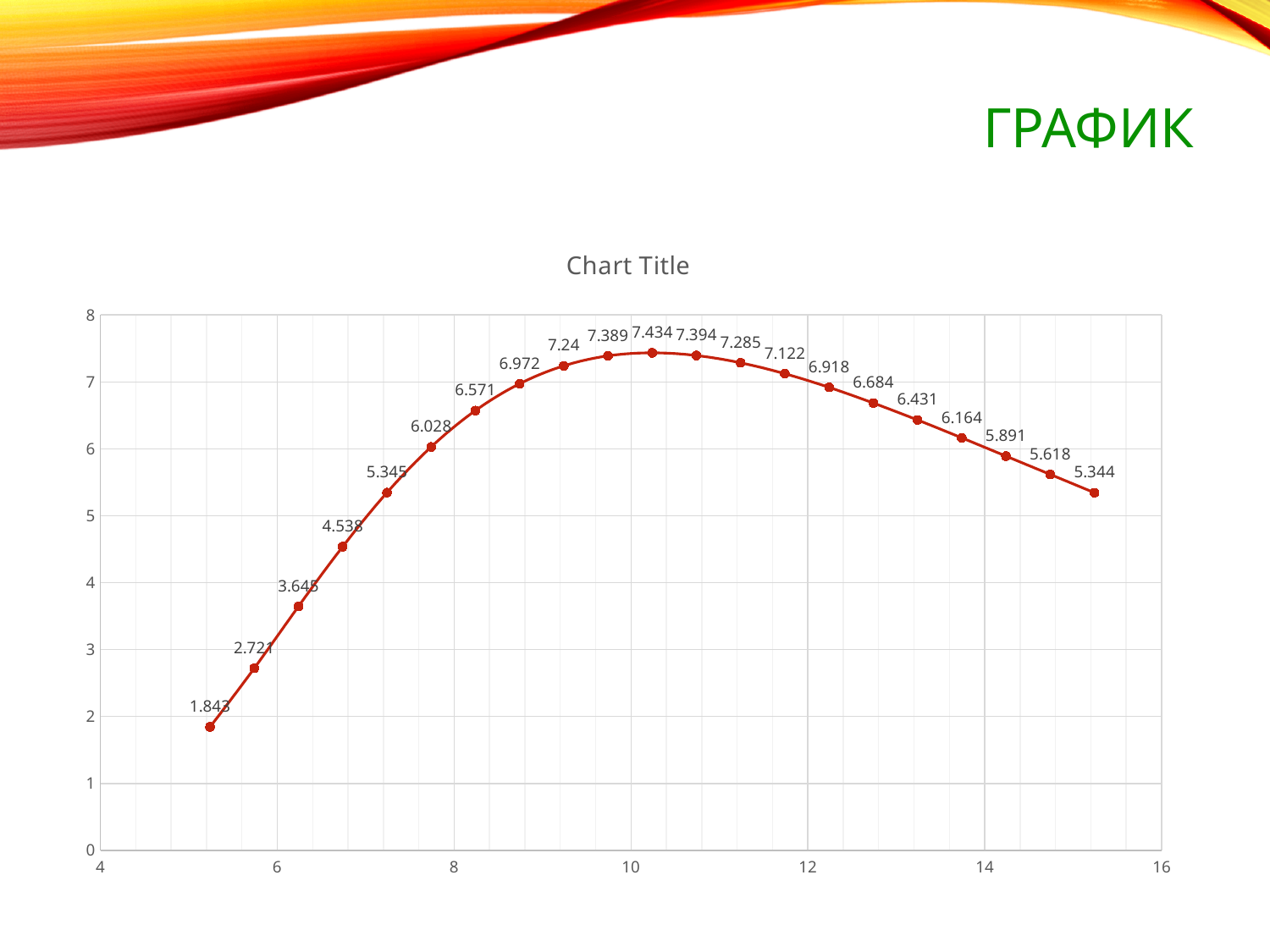
What kind of chart is shown on the slide? line chart How do the values change along the x axis? rise to a peak, then fall What is the value of the last (rightmost) data point? 5.344 What is the title of the chart? Chart Title What is the value of the first (leftmost) data point? 1.843 What is the lowest data label value on the chart? 1.843 Is the value of the data point at the peak of the curve greater or less than 7? greater What is the highest data label value on the chart? 7.434 What is the difference between the highest value (7.434) and the lowest value (1.843)? 5.591 How many data points are plotted on the chart? 21 What is the difference between the last data point (5.344) and the first data point (1.843)? 3.501 Which is larger, the first data point (1.843) or the last data point (5.344)? 5.344